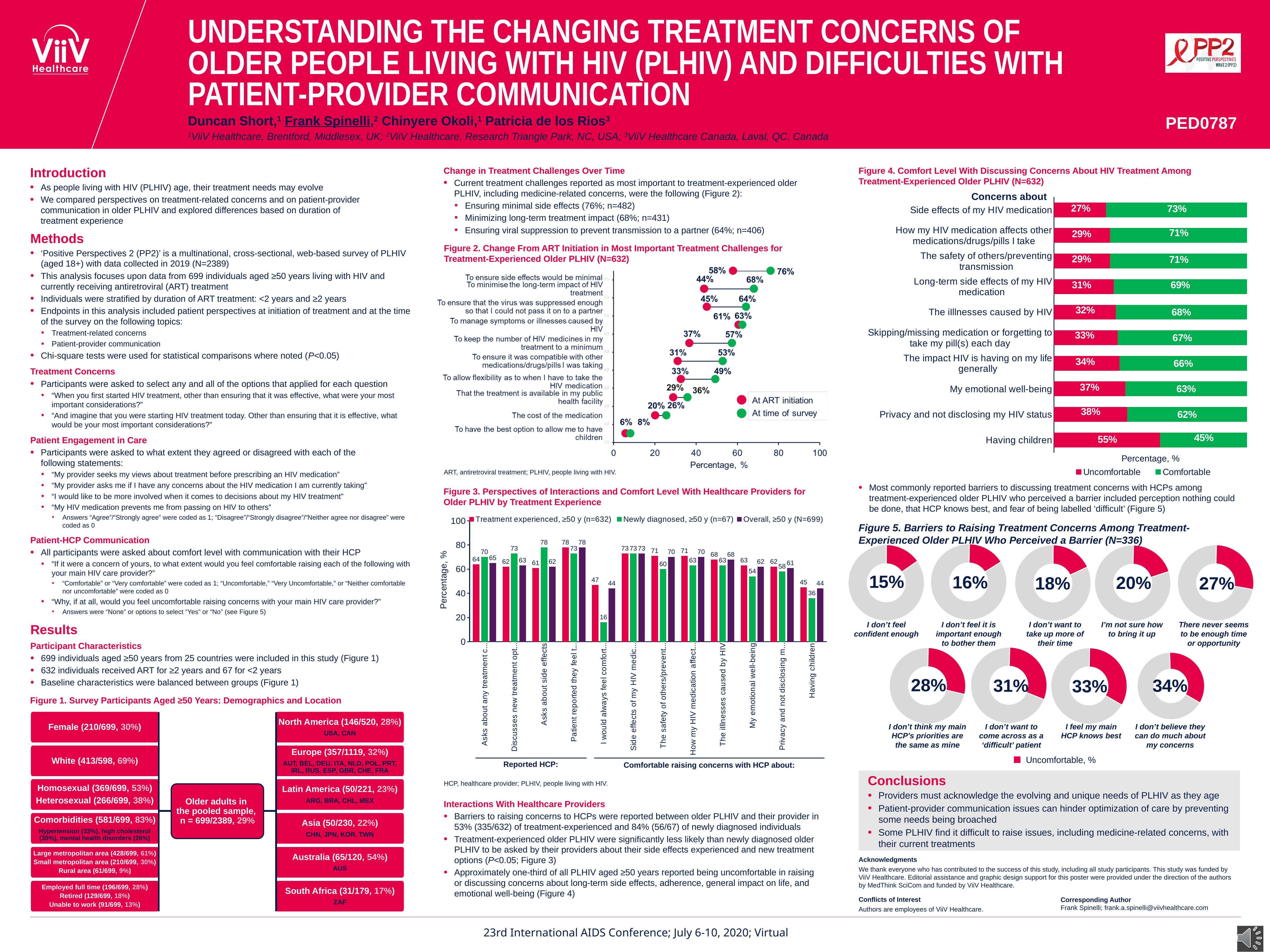
In Figure 2, which treatment challenge has the lowest percentage at ART initiation? To have the best option to allow me to have children In Figure 3, which is larger for 'I would always feel comfort...': the treatment experienced group or the newly diagnosed group? Treatment experienced How many series does the legend in Figure 4 list? 2 In Figure 3, what is the value for 'Asks about side effects' among newly diagnosed individuals (≥50 y, n=67)? 78 In Figure 4, what is the difference between the comfortable and uncomfortable percentages for 'Having children'? 10% In Figure 4, which concern has the highest percentage of respondents who were uncomfortable discussing it? Having children What kind of chart is Figure 3? Bar chart In Figure 2, by how many percentage points did 'To keep the number of HIV medicines in my treatment to a minimum' change from ART initiation to the time of survey? 20% In Figure 5, what percentage of respondents reported 'I don't believe they can do much about my concerns' as a barrier? 34% How many barriers are shown in Figure 5? 9 In Figure 2, what percentage selected 'To ensure side effects would be minimal' at the time of survey? 76% In Figure 4, what percentage of treatment-experienced older PLHIV were uncomfortable discussing side effects of their HIV medication? 27%